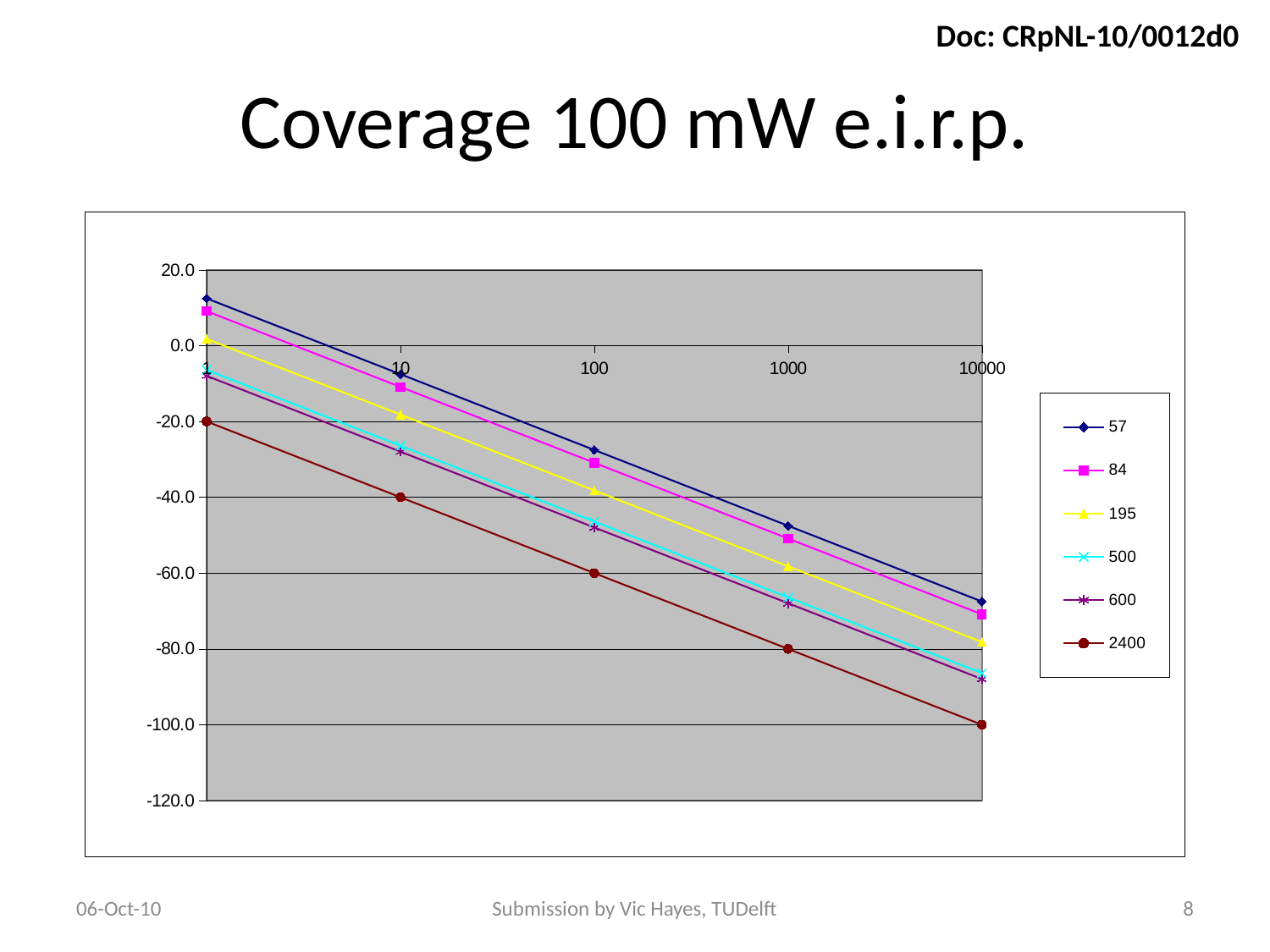
Is the value of the 57 series at x = 1000 greater or less than -40.0? less Which series is larger at x = 100, 84 or 500? 84 How many x-axis points are plotted for each series? 5 Which series has the lowest value at x = 10000? 2400 Do the values of the 57 series rise or fall as x increases? fall What is the value of the 2400 series at x = 1? -20.0 What is the difference between the 2400 series values at x = 1 and x = 10000? 80.0 How many series does the legend list? 6 What is the value of the 2400 series at x = 100? -60.0 What is the value of the 2400 series at x = 10000? -100.0 Which series has the highest value at x = 1? 57 What kind of chart is shown on the slide? line chart